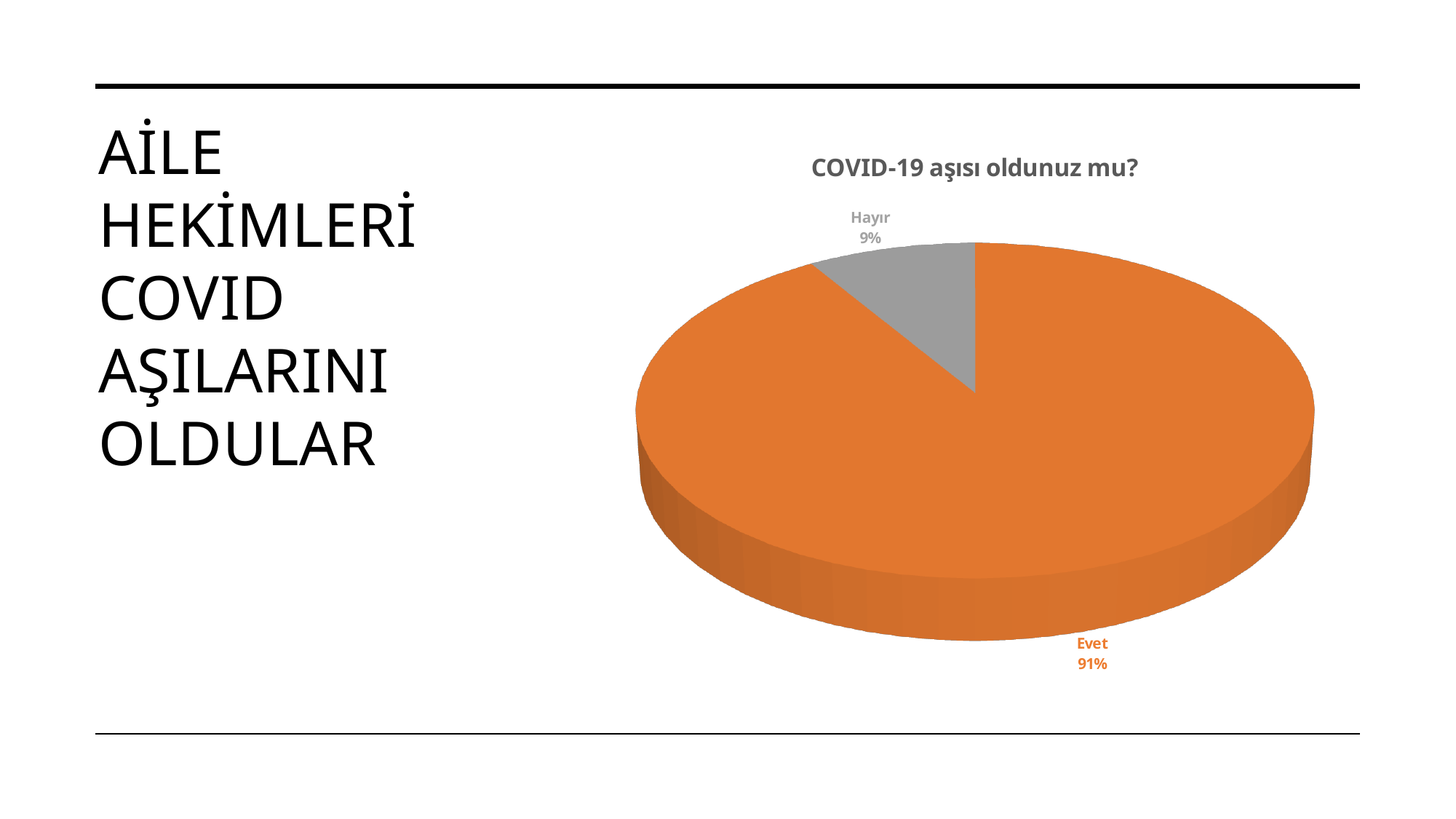
Which slice of the pie is the largest? Evet Which is larger, the Evet slice or the Hayır slice? Evet What kind of chart is shown on the slide? pie chart What share of the pie does the Hayır slice represent? 9% How many slices does the pie chart have? 2 Which slice of the pie is the smallest? Hayır What is the title of the chart? COVID-19 aşısı oldunuz mu? What is the difference in percentage points between the Evet and Hayır slices? 82 What share of the pie does the Evet slice represent? 91% What colour is the Evet slice? orange